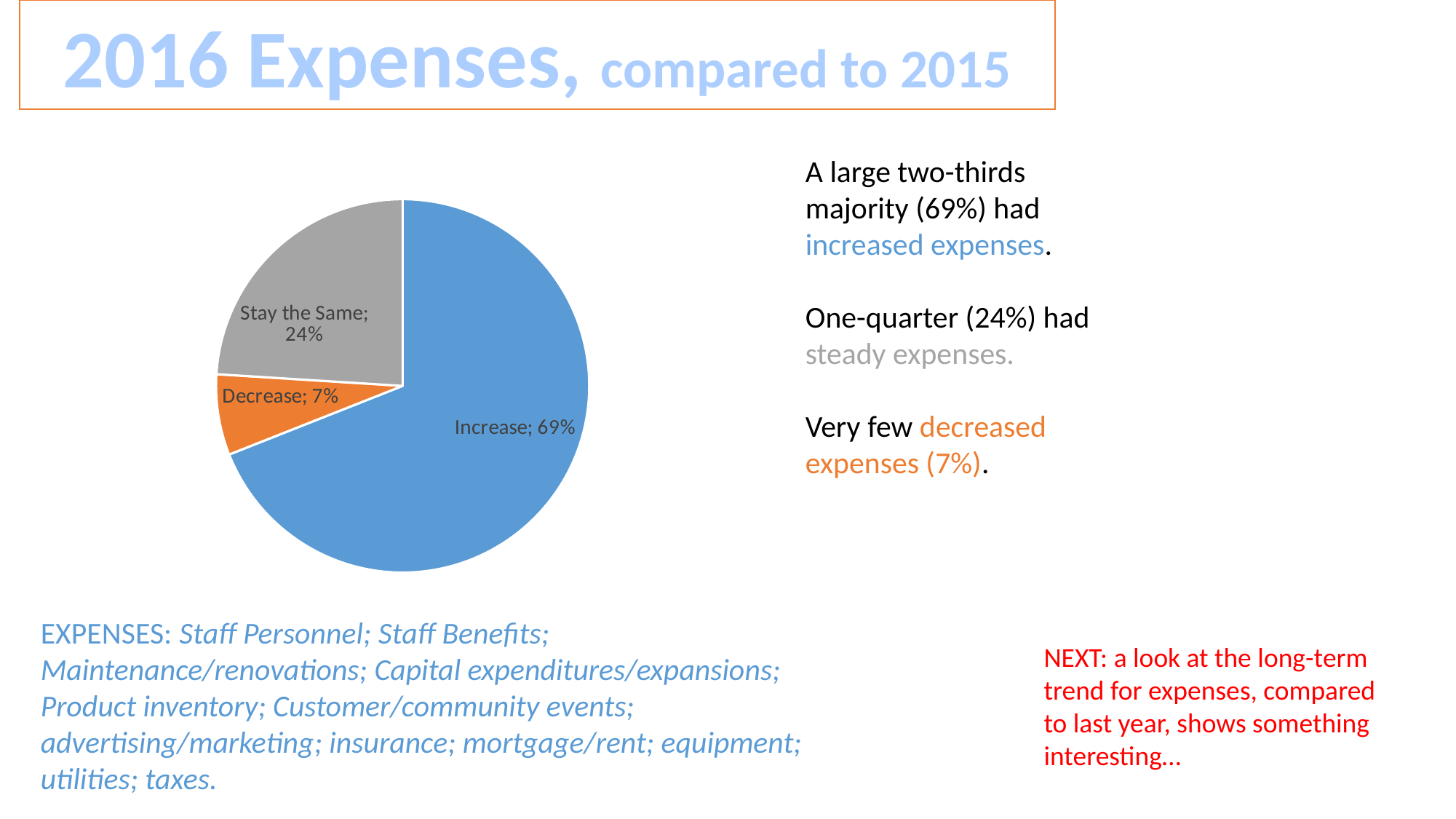
What colour is the Stay the Same slice of the pie chart? Grey What percentage of the pie chart is labelled Increase? 69% What colour is the Decrease slice of the pie chart? Orange How many slices does the pie chart have? 3 Which slice of the pie chart is the smallest? Decrease What percentage of the pie chart is labelled Stay the Same? 24% What kind of chart is shown on the slide? Pie chart What is the difference in percentage points between the Increase slice and the Stay the Same slice? 45 Which slice of the pie chart is the largest? Increase What percentage of the pie chart is labelled Decrease? 7% Which is larger, the Stay the Same slice or the Decrease slice? Stay the Same What is the difference in percentage points between the Stay the Same slice and the Decrease slice? 17